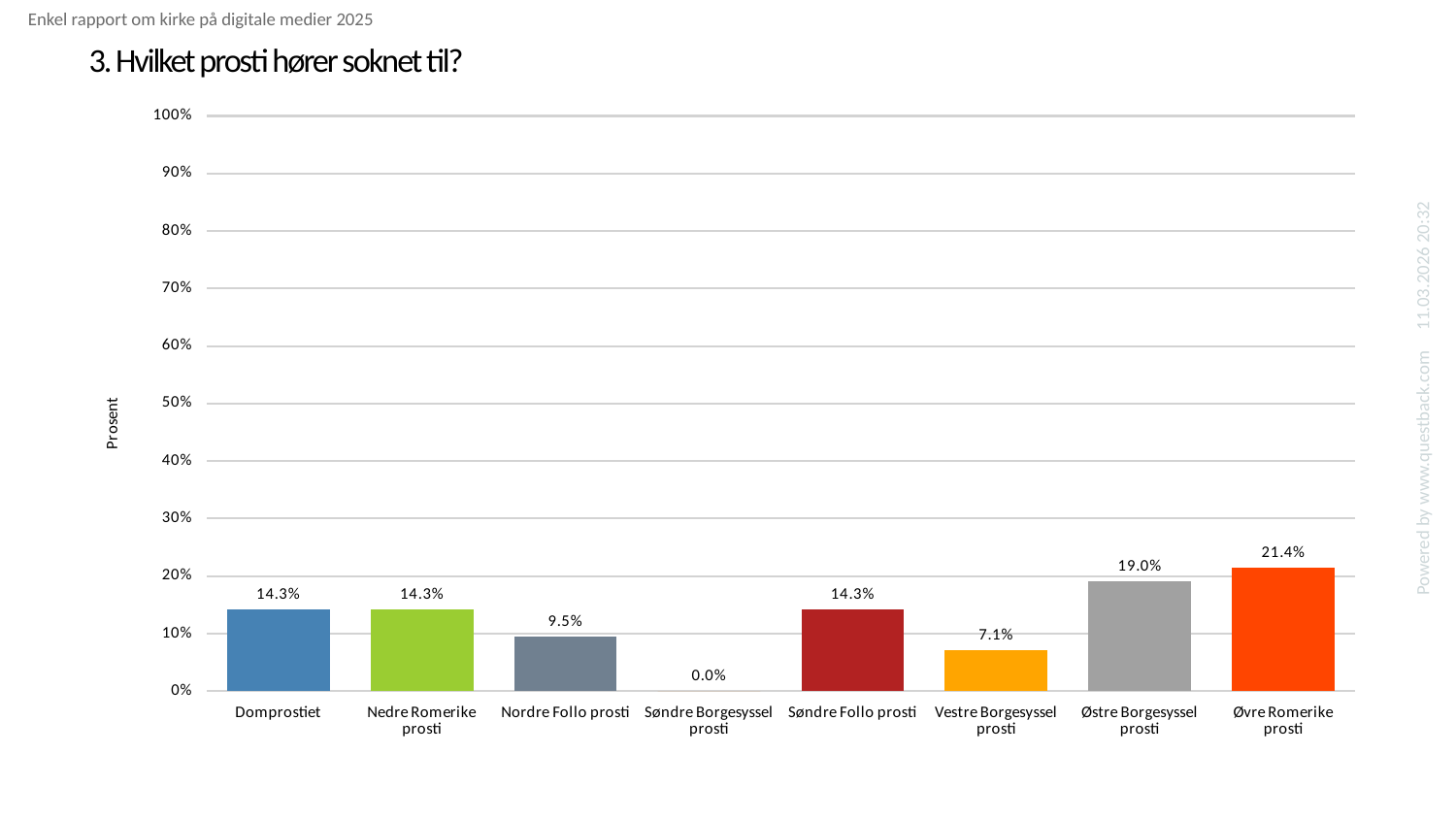
Which category has the lowest value? Søndre Borgesyssel prosti How many categories are shown on the x axis? 8 What is the value for Nordre Follo prosti? 9.5% Is the value for Østre Borgesyssel prosti greater or less than 10%? greater What kind of chart is shown on the slide? bar chart What is the title of the chart? 3. Hvilket prosti hører soknet til? What is the difference between the values for Øvre Romerike prosti and Østre Borgesyssel prosti? 2.4% What is the value for Østre Borgesyssel prosti? 19.0% Which category has the highest value? Øvre Romerike prosti What is the value for Vestre Borgesyssel prosti? 7.1% Which is larger, the value for Nordre Follo prosti or the value for Vestre Borgesyssel prosti? Nordre Follo prosti What is the value for Øvre Romerike prosti? 21.4%